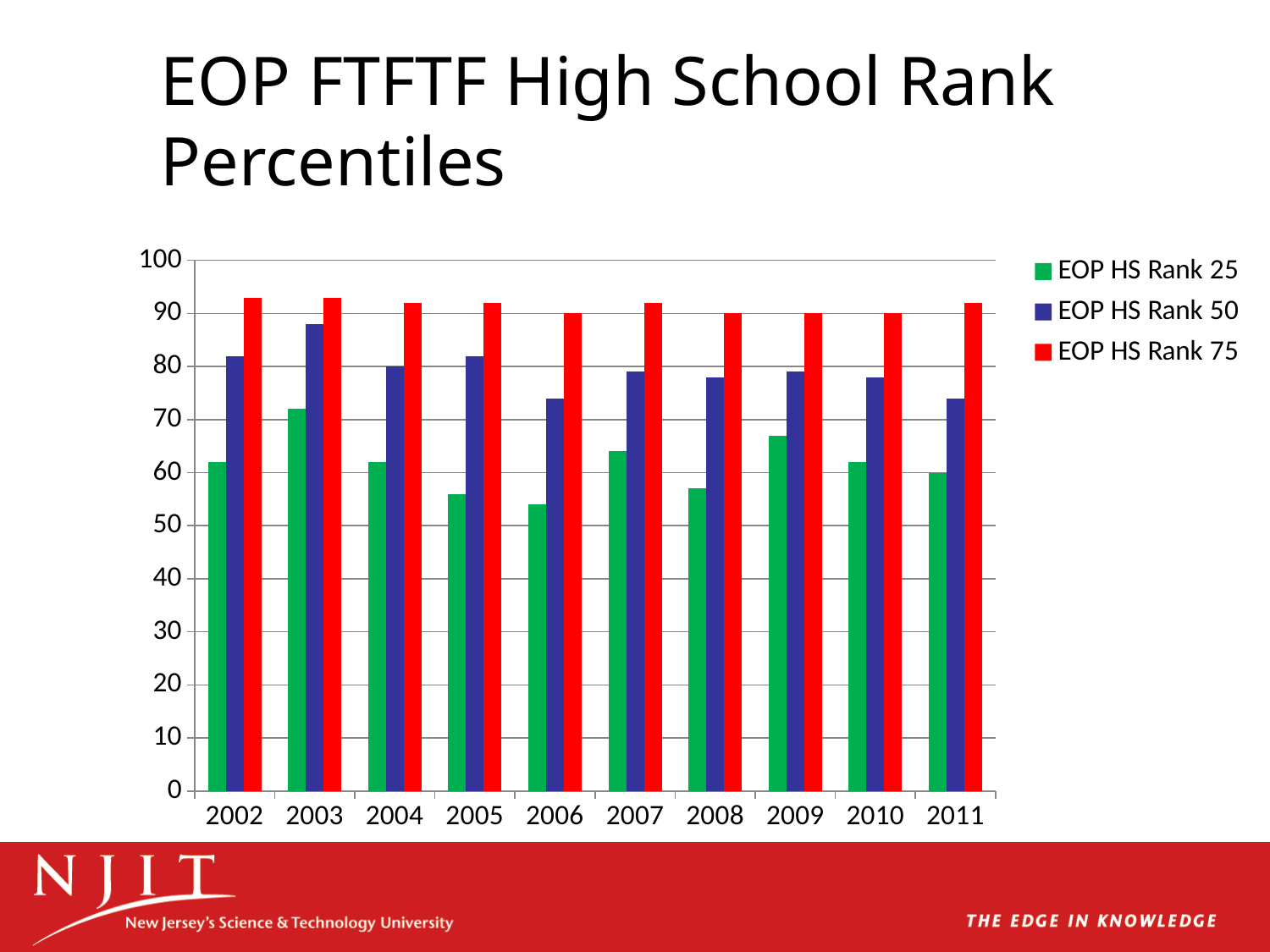
What colour represents EOP HS Rank 75 in the chart? red How many years are shown on the x axis? 10 Which is larger, the EOP HS Rank 25 value for 2003 or for 2006? 2003 How many series does the legend list? 3 Which year has the highest value for EOP HS Rank 50? 2003 Is the value for EOP HS Rank 25 in 2003 greater or less than 70? greater Is the value for EOP HS Rank 50 in 2006 greater or less than 80? less What kind of chart is shown on the slide? bar chart Is the value for EOP HS Rank 25 in 2006 greater or less than 60? less Does the EOP HS Rank 25 value rise or fall from 2003 to 2006? fall Which year has the highest value for EOP HS Rank 25? 2003